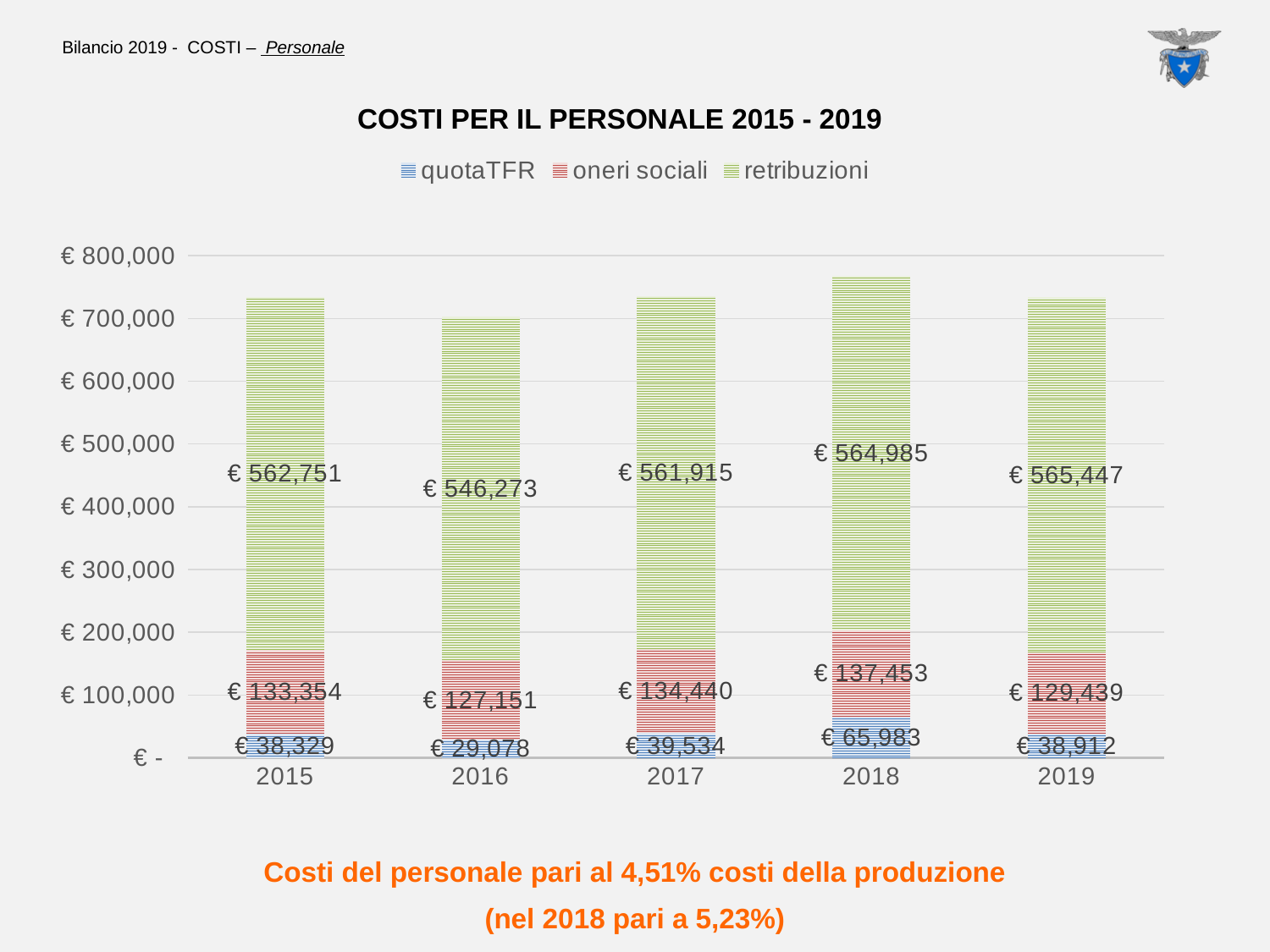
Which year has the highest quotaTFR value? 2018 What is the total of the stacked bar for 2016? € 702,502 What is the oneri sociali value for 2019? € 129,439 Is the total stacked bar for 2018 greater or less than € 700,000? greater What is the retribuzioni value for 2018? € 564,985 What kind of chart is shown? stacked bar chart How many years are shown on the x axis? 5 Which is larger, the oneri sociali value for 2017 or for 2016? 2017 How many series does the legend list? 3 Which year has the lowest retribuzioni value? 2016 What is the difference between the quotaTFR values for 2018 and 2017? € 26,449 What is the quotaTFR value for 2016? € 29,078